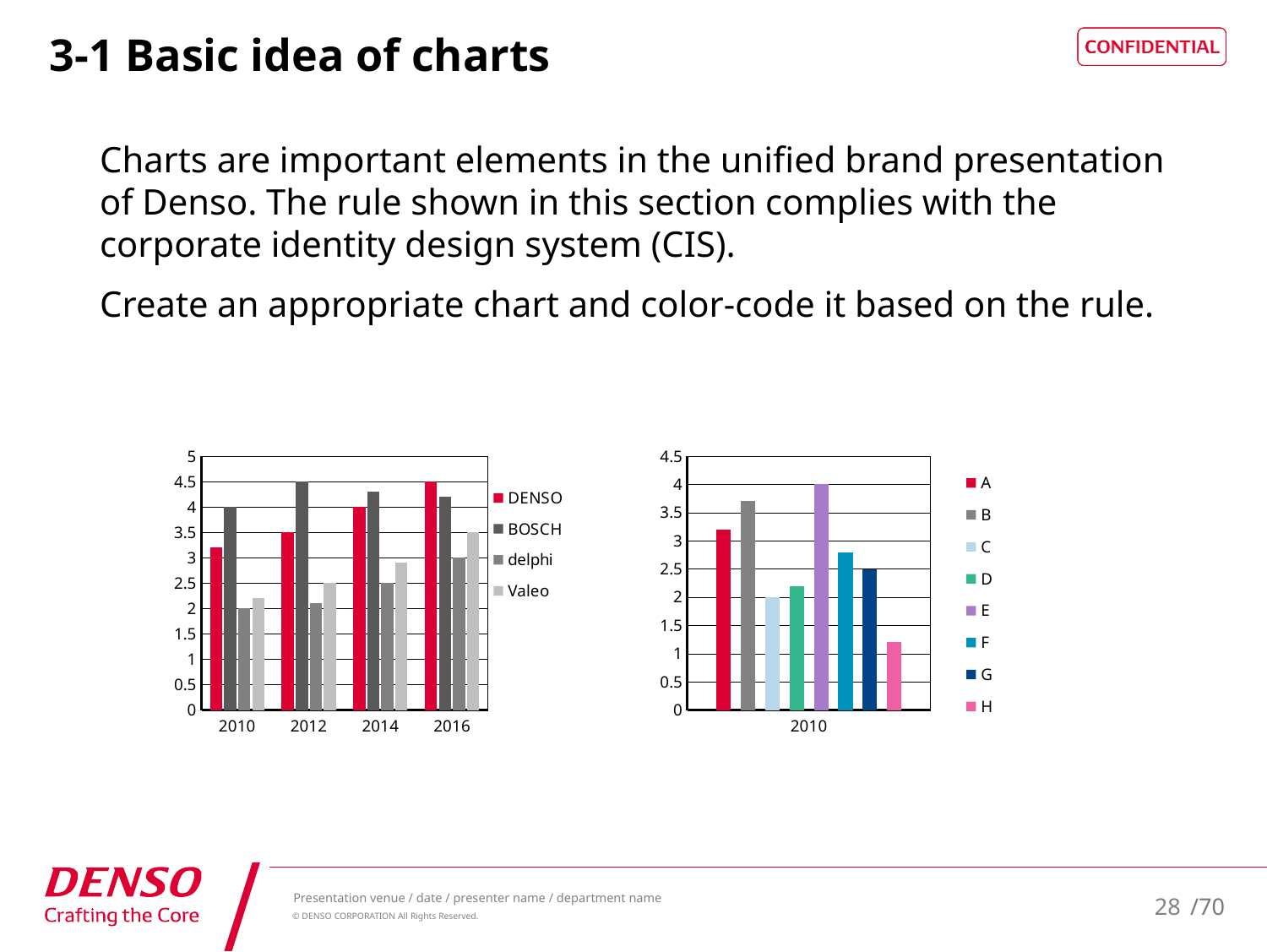
In the left chart, which is larger for 2014: delphi or Valeo? Valeo In the right chart, what is the value for E? 4 In the left chart, which series has the highest bar for 2010? BOSCH In the left chart, do the DENSO values rise or fall from 2010 to 2016? rise In the right chart, is the value for A greater or less than 3? greater How many series does the legend of the right chart list? 8 In the left chart, what colour are the DENSO bars? red In the right chart, which series has the lowest bar? H How many series does the legend of the left chart list? 4 What kind of chart is the chart on the left of the slide? bar chart How many years are shown on the x axis of the left chart? 4 In the right chart, which series has the highest bar? E